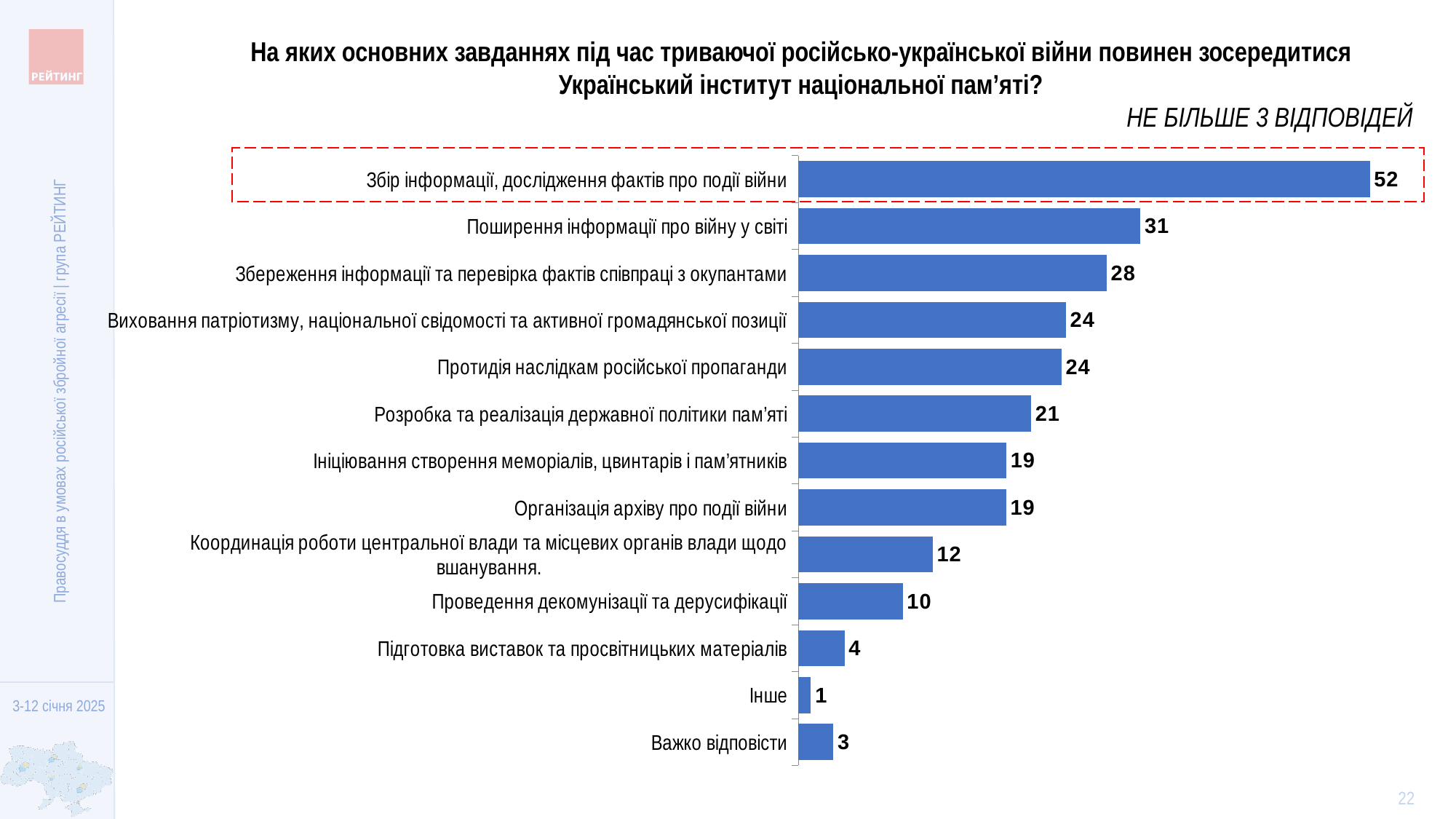
How many categories are shown in the chart? 13 What value is shown for "Проведення декомунізації та дерусифікації"? 10 Which category has the lowest value? Інше Which category is highlighted with a red dashed box? Збір інформації, дослідження фактів про події війни What is the difference between the values for "Збір інформації, дослідження фактів про події війни" and "Поширення інформації про війну у світі"? 21 Which is larger: the value for "Збереження інформації та перевірка фактів співпраці з окупантами" or the value for "Розробка та реалізація державної політики пам'яті"? Збереження інформації та перевірка фактів співпраці з окупантами What value is shown for "Важко відповісти"? 3 What is the difference between the values for "Координація роботи центральної влади та місцевих органів влади щодо вшанування" and "Підготовка виставок та просвітницьких матеріалів"? 8 Which category has the highest value? Збір інформації, дослідження фактів про події війни What value is shown for "Поширення інформації про війну у світі"? 31 What value is shown for "Збір інформації, дослідження фактів про події війни"? 52 What kind of chart is shown on the slide? Bar chart